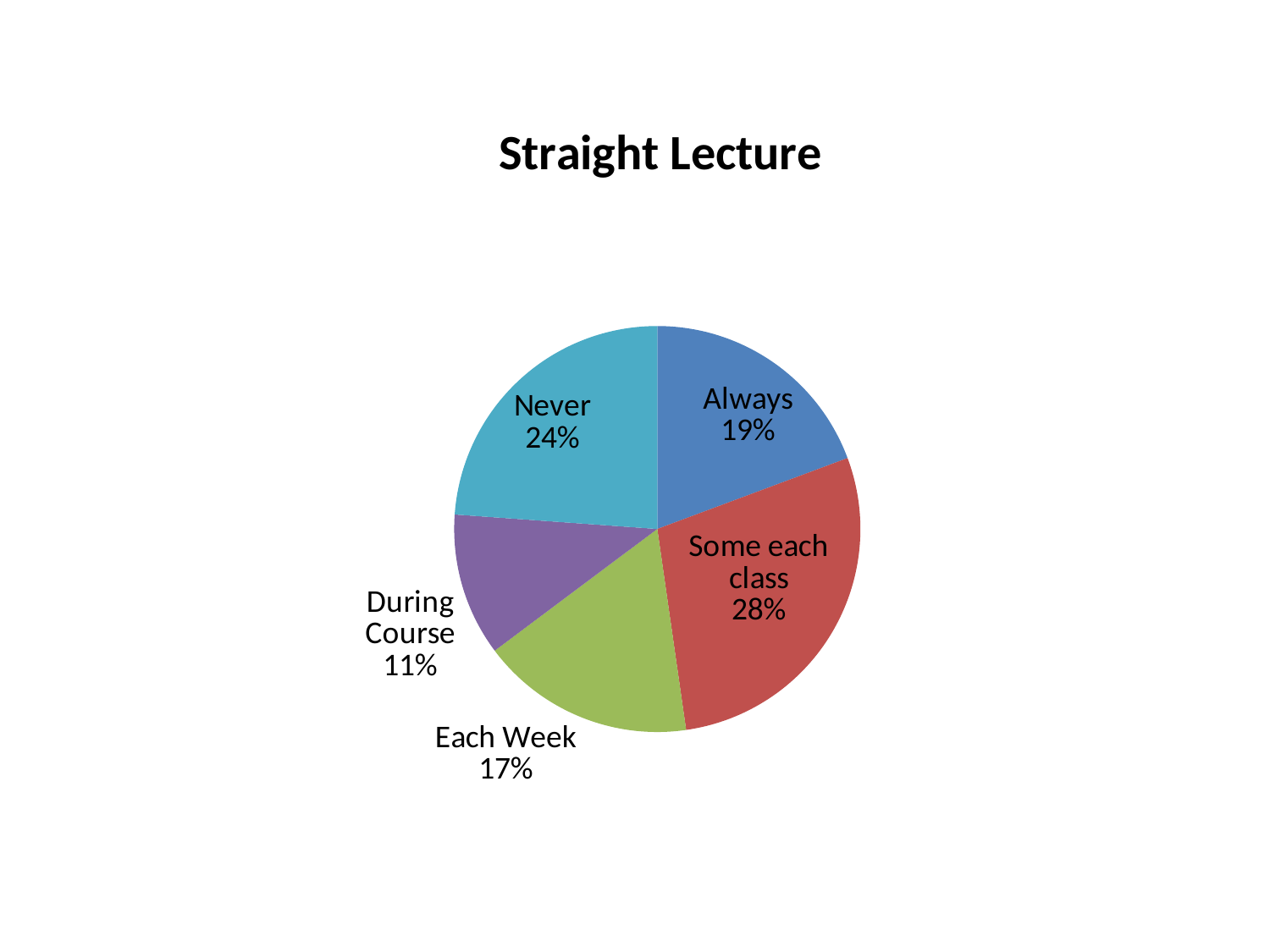
What percentage is shown for 'Each Week'? 17% What percentage is shown for 'Never'? 24% What percentage is shown for 'During Course'? 11% What is the difference in percentage points between 'Never' and 'Always'? 5 Which slice has the smallest share of the pie? During Course What is the title of the chart? Straight Lecture What kind of chart is shown on the slide? pie chart What colour is the 'Never' slice? light blue What percentage of the pie is the 'Some each class' slice? 28% Which is larger, the 'Always' slice or the 'Each Week' slice? Always Which slice has the largest share of the pie? Some each class How many slices does the pie chart have? 5